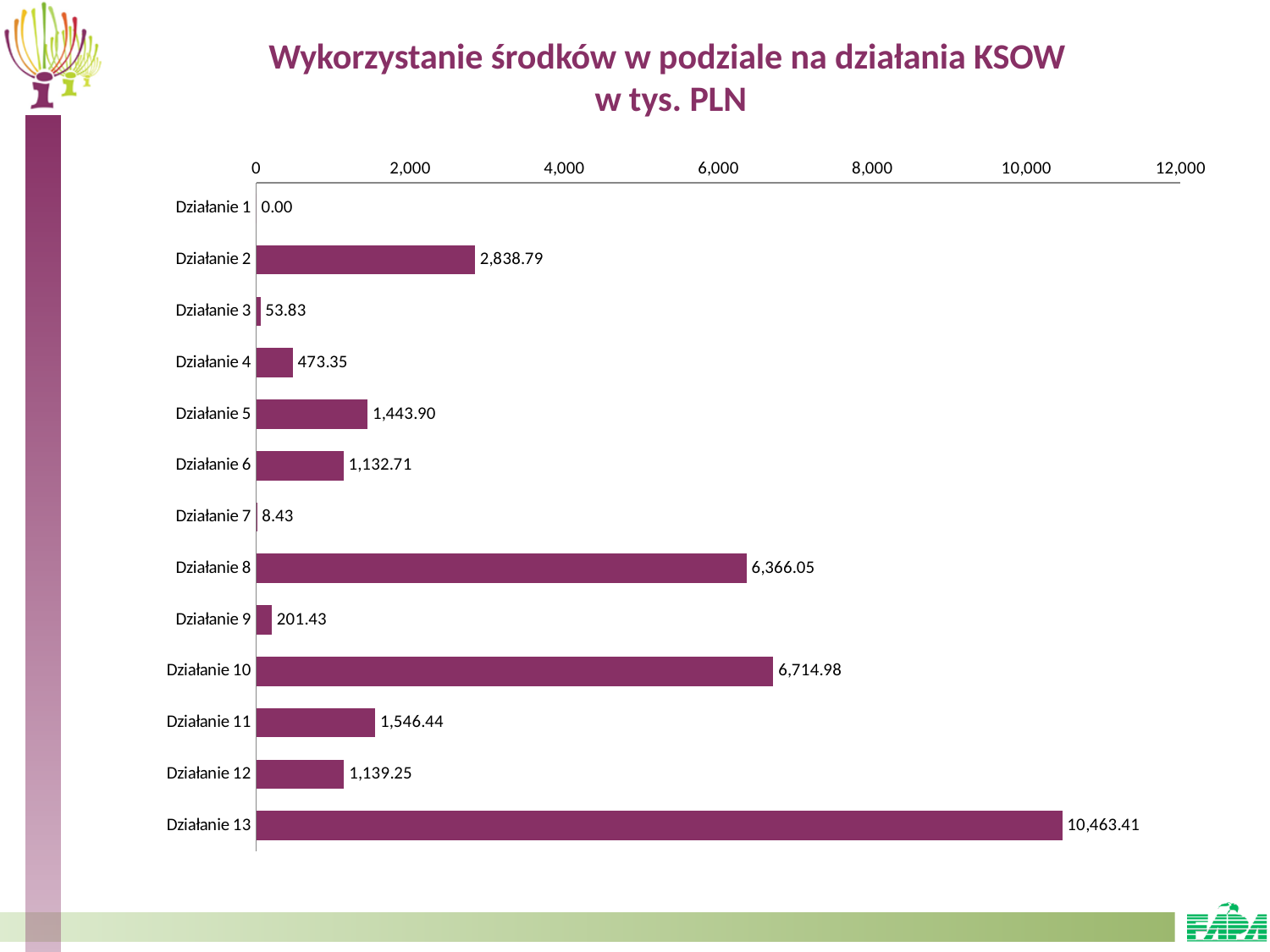
Which category has the highest value? Działanie 13 What is the value for Działanie 4? 473.35 Which is larger, the value for Działanie 2 or the value for Działanie 5? Działanie 2 What is the value for Działanie 13? 10,463.41 What is the difference between the values for Działanie 10 and Działanie 8? 348.93 How many categories are shown in the chart? 13 What is the difference between the values for Działanie 13 and Działanie 10? 3,748.43 Which category has the lowest value? Działanie 1 Is the value for Działanie 8 greater or less than 6,000? greater What is the value for Działanie 8? 6,366.05 What kind of chart is shown on the slide? bar chart What is the title of the chart? Wykorzystanie środków w podziale na działania KSOW w tys. PLN